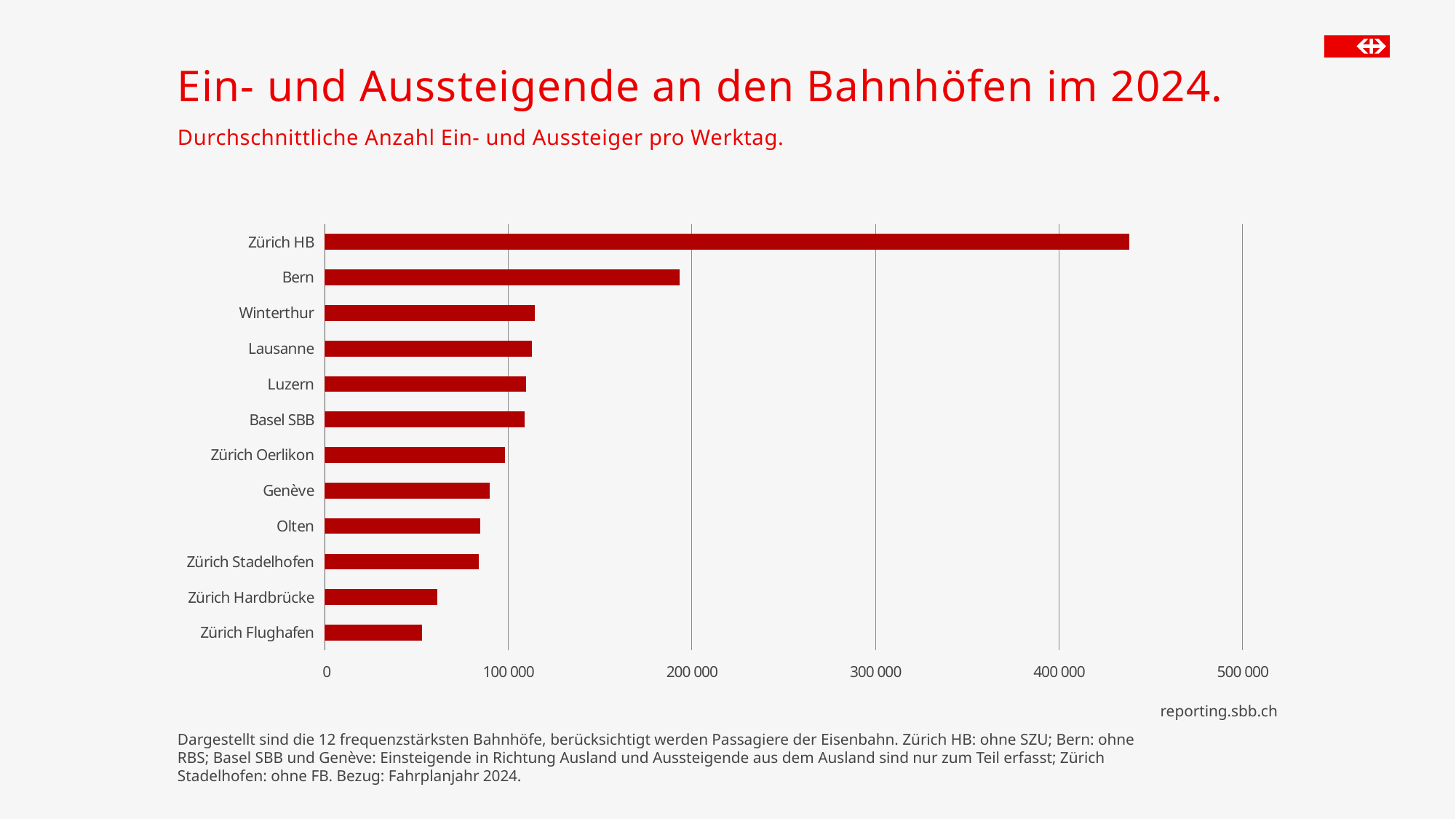
Is the value for Zürich Flughafen greater or less than 100 000? less Is the value for Bern greater or less than 200 000? less Is the value for Genève greater or less than 100 000? less Which station has the lowest value in the chart? Zürich Flughafen Which has a higher value, Bern or Winterthur? Bern How many stations are shown in the chart? 12 What kind of chart is shown on the slide? bar chart Which station has the highest average number of passengers boarding and alighting per weekday? Zürich HB What is the title of the chart on the slide? Ein- und Aussteigende an den Bahnhöfen im 2024. Which has a higher value, Genève or Zürich Hardbrücke? Genève